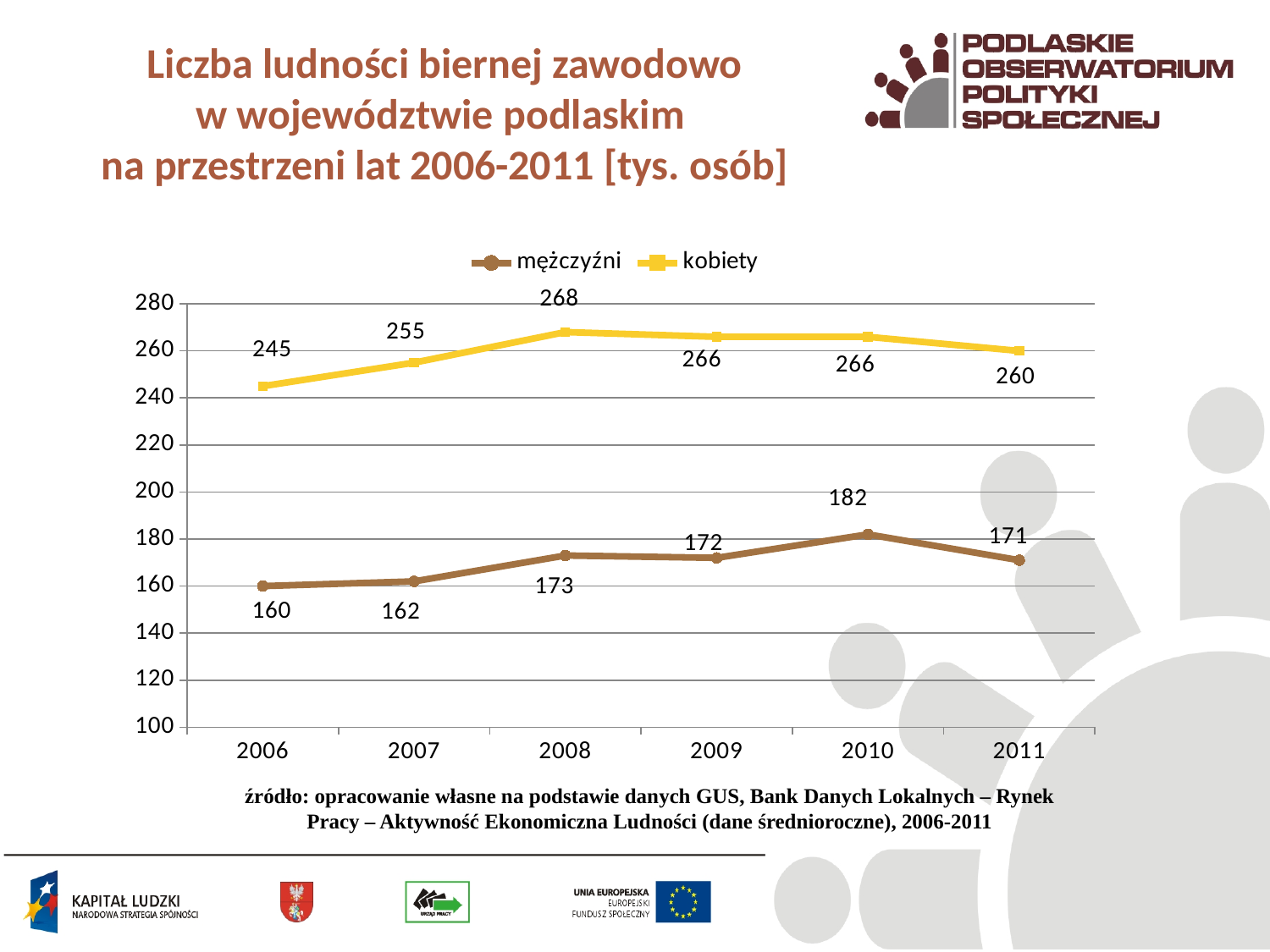
How many years are shown on the x axis? 6 What is the value for mężczyźni in 2006? 160 Does the mężczyźni series rise or fall from 2006 to 2010? rise In which year is the value for mężczyźni lowest? 2006 What is the difference between the kobiety and mężczyźni values in 2011? 89 Is the value for kobiety in 2006 greater or less than 240? greater How many series does the legend list? 2 In which year is the value for kobiety highest? 2008 What is the value for kobiety in 2008? 268 Which is larger: the mężczyźni value in 2008 or in 2009? 2008 What kind of chart is shown on the slide? line chart What is the value for mężczyźni in 2010? 182